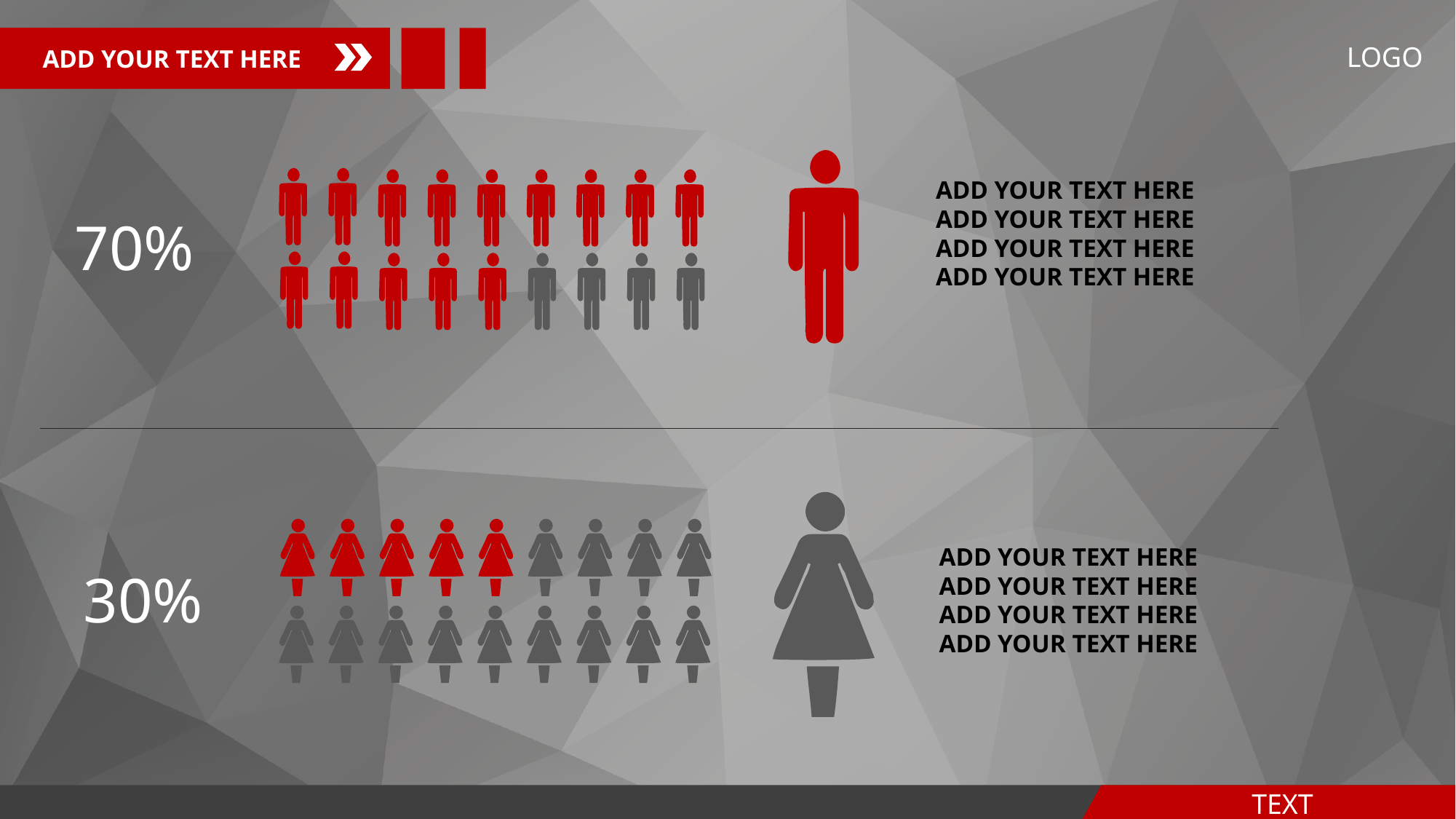
Which group has the larger percentage, the male icons (top) or the female icons (bottom)? Male icons (top), 70% How many of the small male figure icons in the top group are coloured red? 14 What percentage is shown next to the group of female figure icons in the bottom half of the slide? 30% What colour is used to highlight the filled icons in both groups? Red What kind of chart is used on this slide to show the percentages? Pictogram (icon array) chart How many of the small female figure icons in the bottom group are coloured red? 5 Which percentage is paired with the large female figure icon? 30% What do the two percentages on the slide add up to? 100% How many small male figure icons are in the top group? 18 What percentage is shown next to the group of male figure icons in the top half of the slide? 70% What is the difference between the top percentage (70%) and the bottom percentage (30%)? 40%